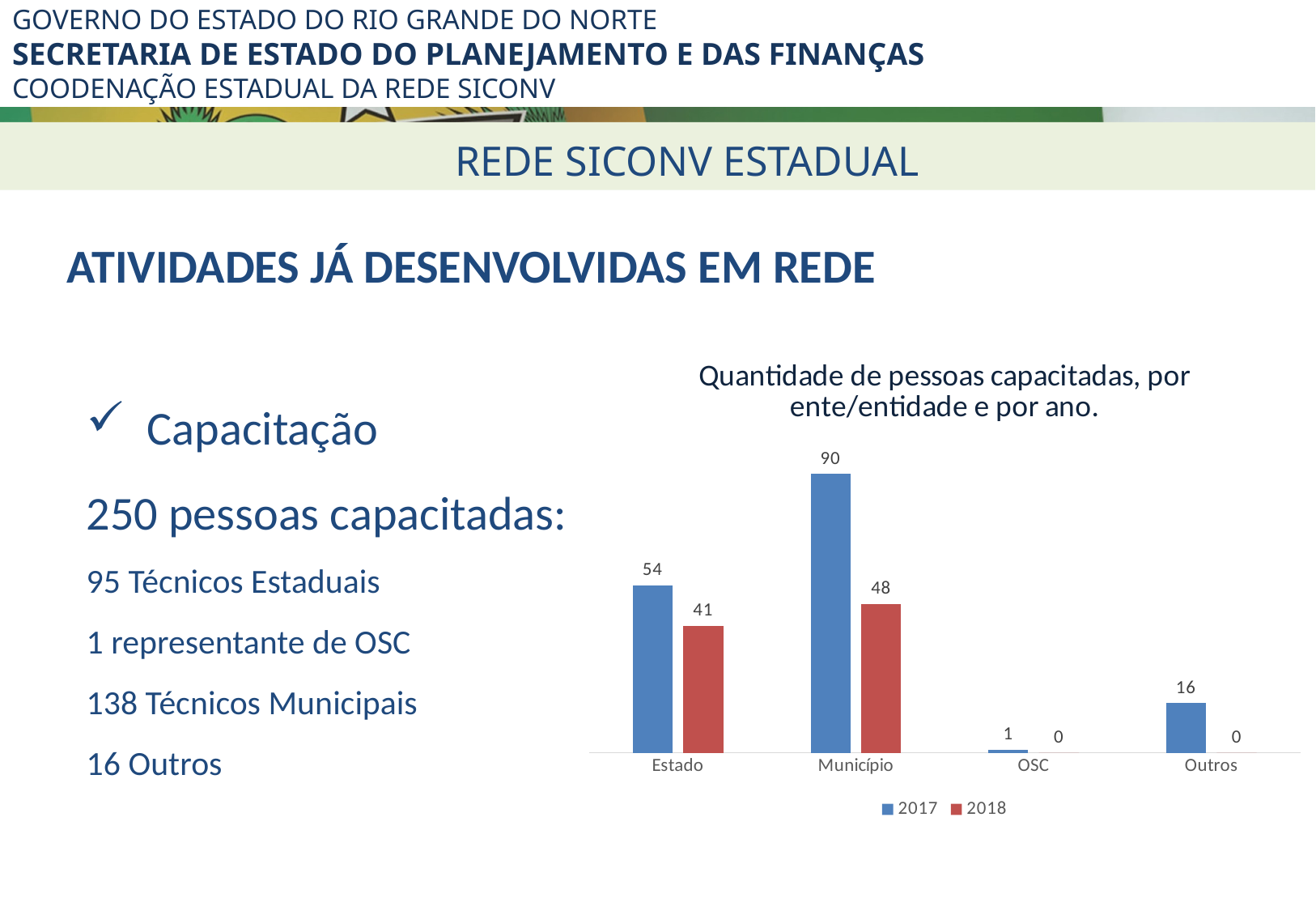
How many categories are shown on the x axis? 4 How many series does the legend list? 2 What is the title of the chart? Quantidade de pessoas capacitadas, por ente/entidade e por ano. What is the value for Outros in 2017? 16 What is the difference between the 2017 and 2018 values for Estado? 13 Which category has the highest value for 2017? Município What kind of chart is shown? Bar chart Which category has the lowest value for 2017? OSC What is the value for OSC in 2018? 0 What is the value for Estado in 2017? 54 Which is larger for Município: the 2017 value or the 2018 value? 2017 What is the value for Município in 2018? 48